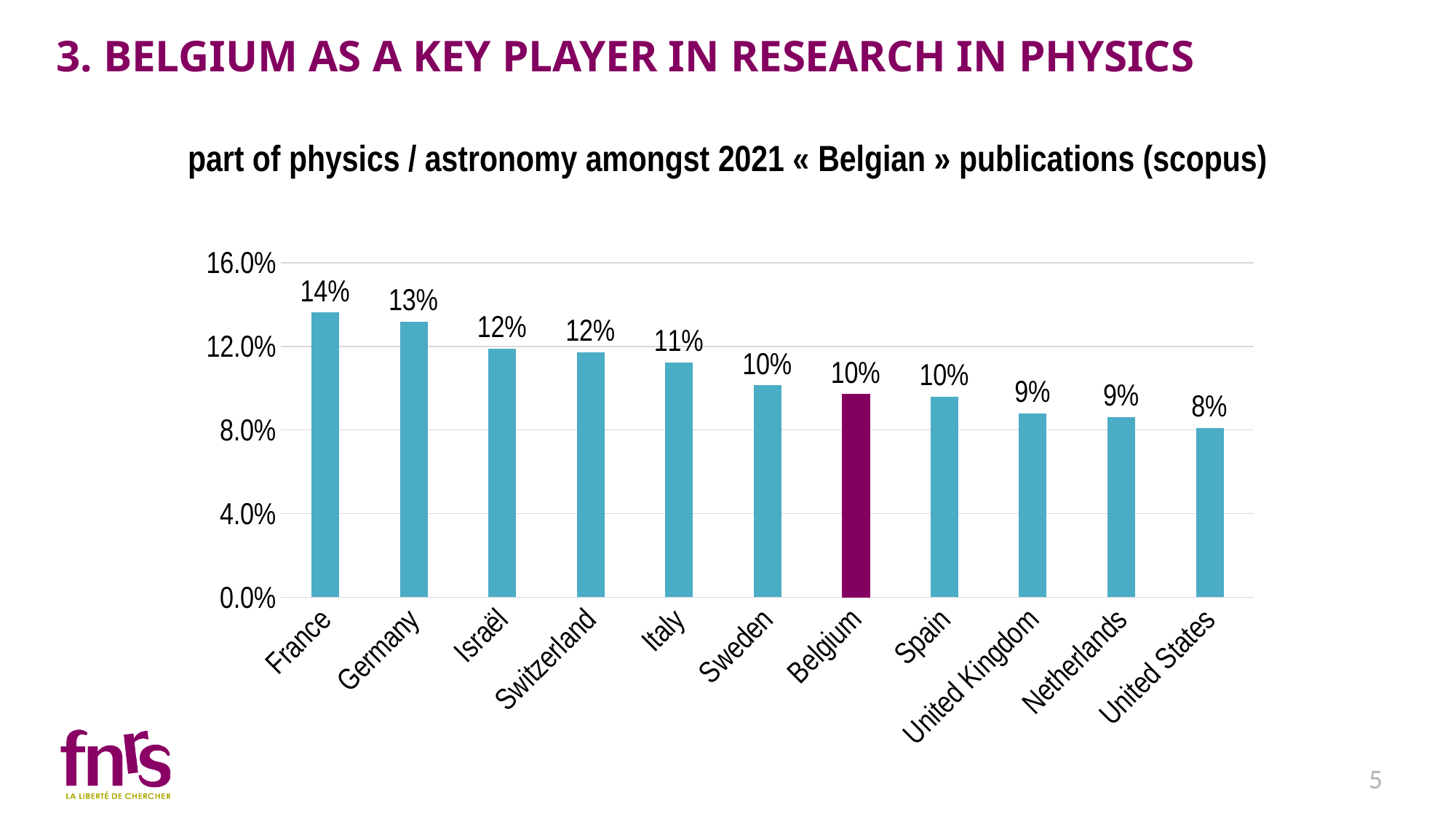
How many countries are shown in the chart? 11 Which country has the lowest value in the chart? United States What is the difference between the values for France and the United States? 6 percentage points Which country's bar is shown in a different colour (purple) from the others? Belgium Do the values rise or fall from left to right across the chart? Fall What is the value shown for Belgium? 10% Which country has the highest value in the chart? France What kind of chart is shown on the slide? Bar chart What is the value shown for France? 14% Is the value for Italy greater or less than 12.0%? less Which has a larger value, France or Germany? France What is the value shown for the United Kingdom? 9%